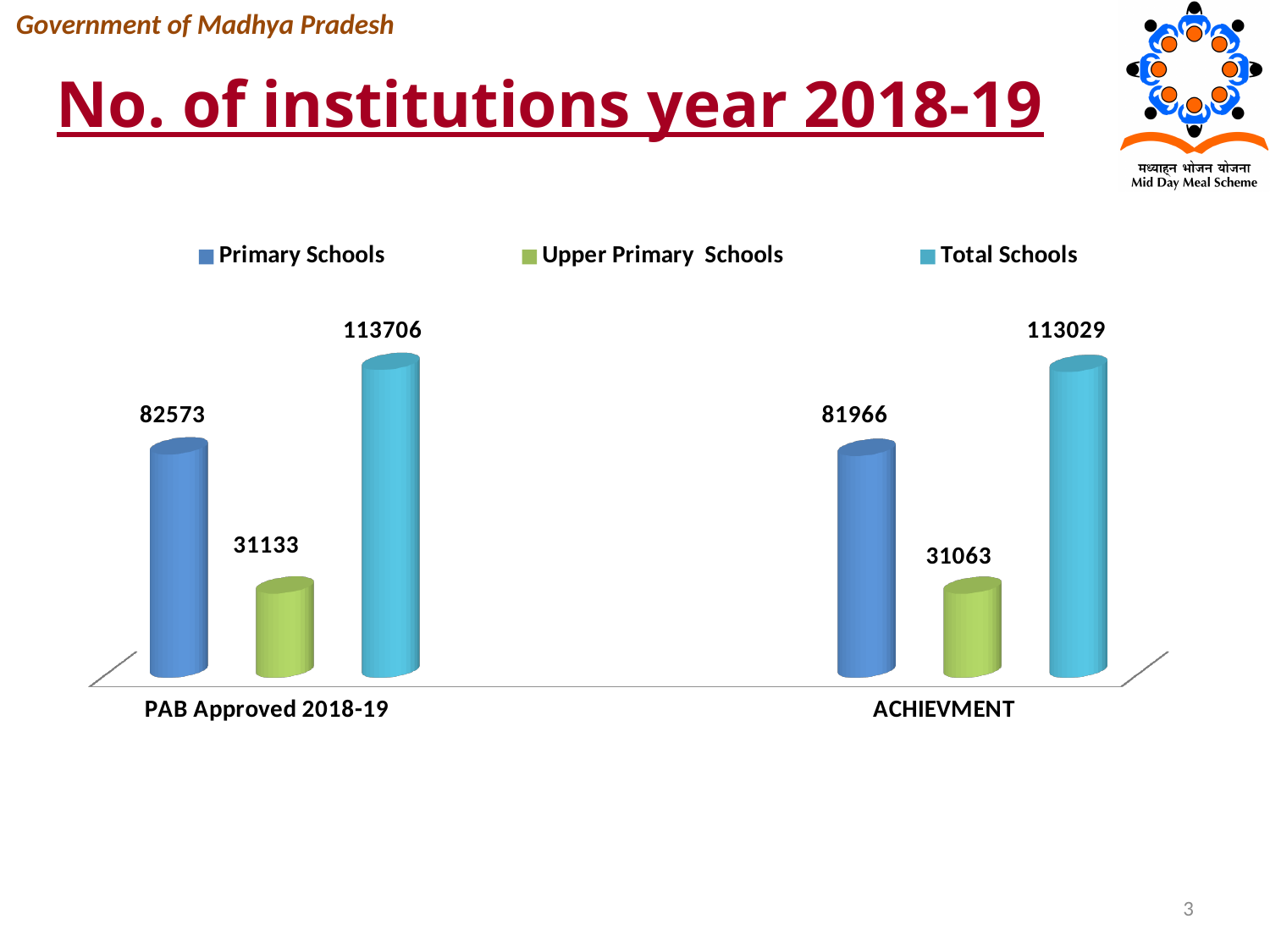
How many series does the legend list? 3 What is the value for Total Schools in the PAB Approved 2018-19 category? 113706 Which series has the lowest value in the PAB Approved 2018-19 category? Upper Primary Schools What is the value for Total Schools in the ACHIEVMENT category? 113029 What kind of chart is shown on the slide? Bar chart How many categories are shown on the x axis? 2 What is the difference between the Total Schools values for PAB Approved 2018-19 and ACHIEVMENT? 677 What is the difference between Primary Schools and Upper Primary Schools in the PAB Approved 2018-19 category? 51440 What is the value for Primary Schools in the PAB Approved 2018-19 category? 82573 Which series has the highest value in the ACHIEVMENT category? Total Schools What is the value for Upper Primary Schools in the ACHIEVMENT category? 31063 Which is larger: Primary Schools for PAB Approved 2018-19 or Primary Schools for ACHIEVMENT? PAB Approved 2018-19